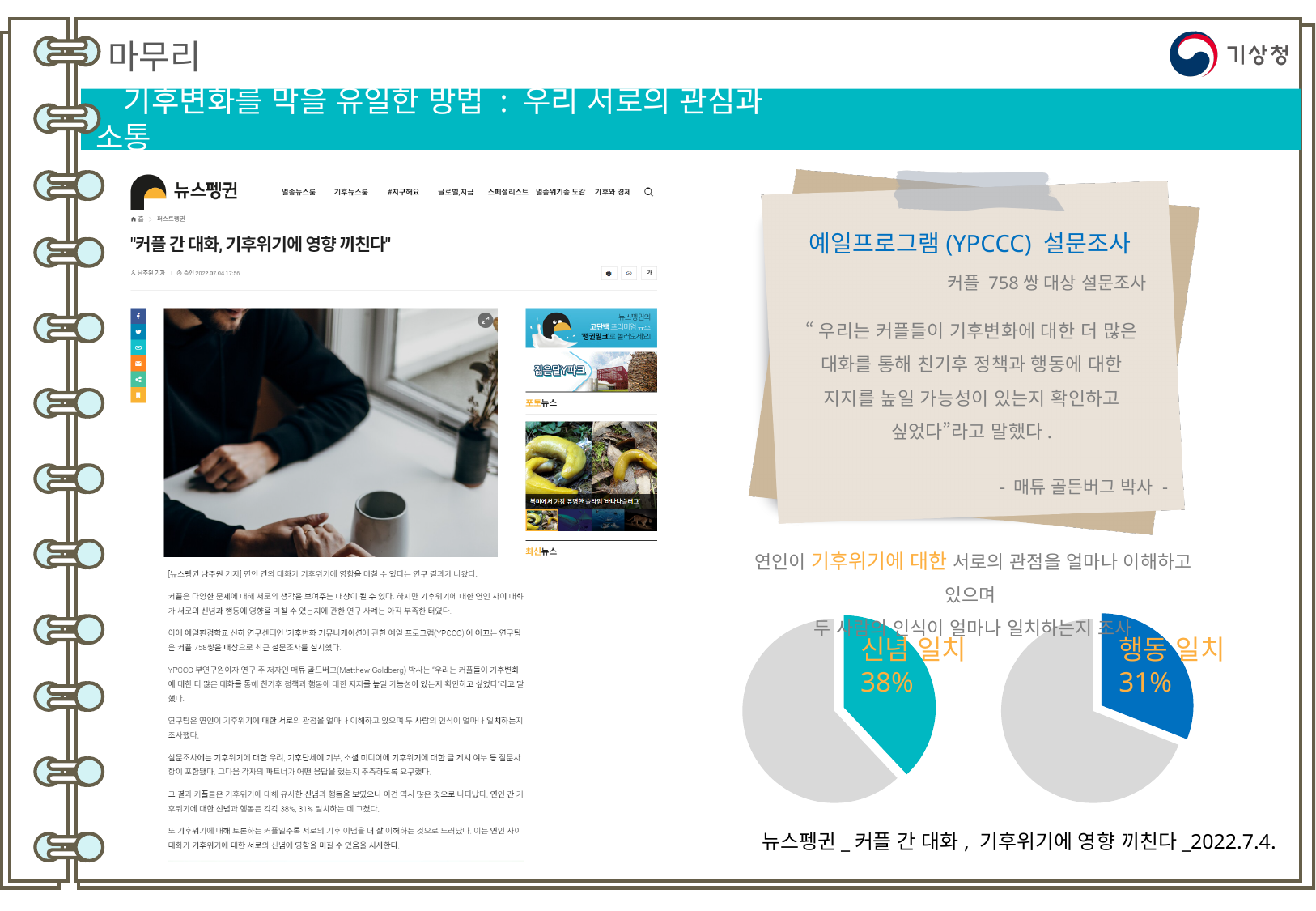
What colour is the highlighted 신념 일치 slice in the left pie chart? teal What kind of chart is used to show 신념 일치 and 행동 일치 on the slide? pie chart Is the 행동 일치 value in the right pie chart greater or less than 50%? less In the right pie chart, what share of the pie does the highlighted 행동 일치 slice represent? 31% In the left pie chart, what percentage is shown for 신념 일치? 38% In the left pie chart, what share of the pie does the highlighted 신념 일치 slice represent? 38% What colour is the highlighted 행동 일치 slice in the right pie chart? blue What is the difference between the 신념 일치 value (left pie chart) and the 행동 일치 value (right pie chart)? 7 percentage points How many pie charts are shown on the slide? 2 In the right pie chart, what percentage is shown for 행동 일치? 31% Which is larger, the 신념 일치 value in the left pie chart or the 행동 일치 value in the right pie chart? 신념 일치 How many slices does each pie chart on the slide have? 2